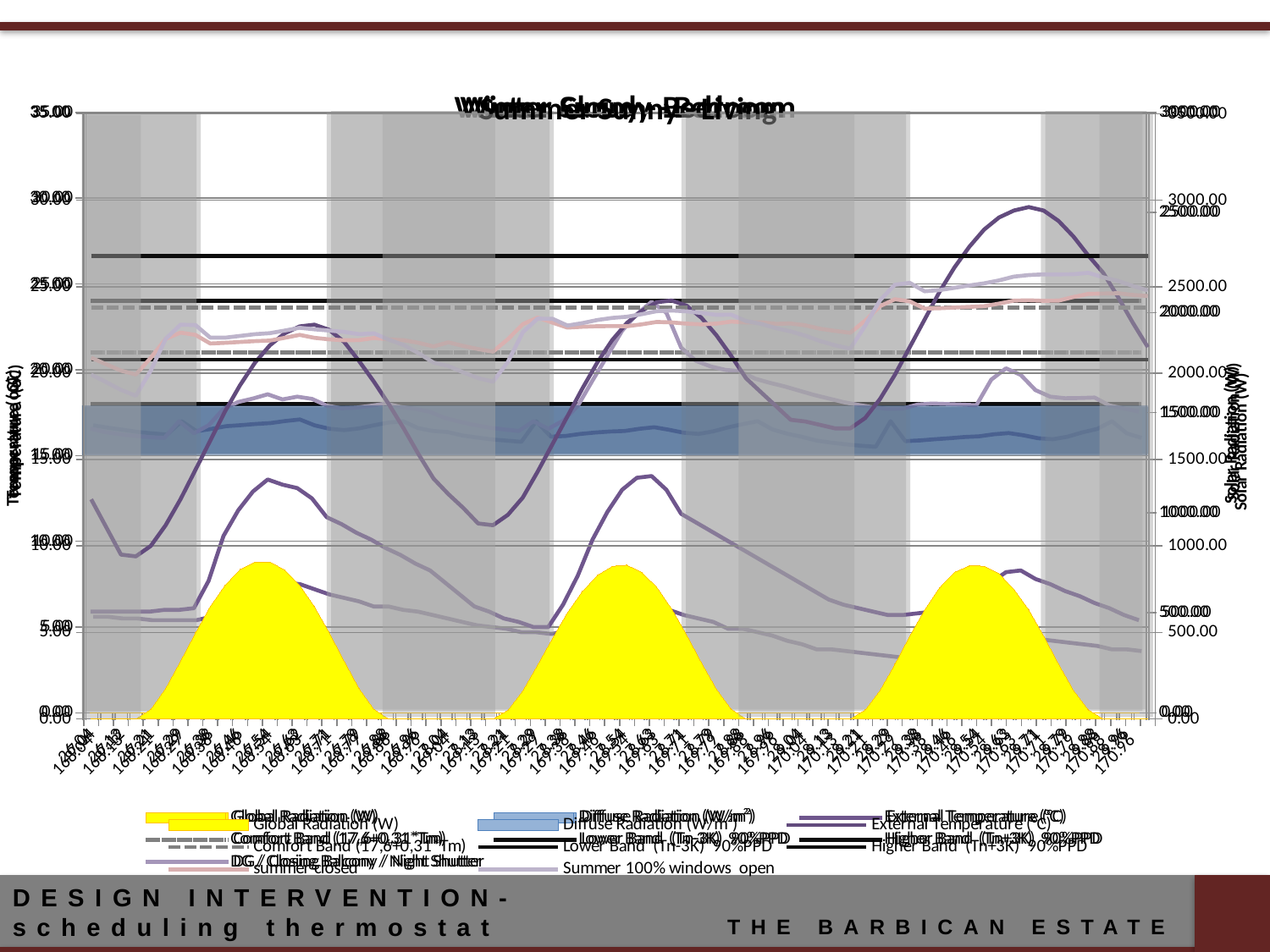
How many yellow peaks (daily cycles of the filled area) are shown across the chart? 3 What kind of chart is this (lines plotted over a filled area)? combination area and line chart Do the daily peaks of the dark purple line rise or fall from left to right across the chart? rise Which series is drawn as the yellow filled area? Global Radiation (W) What is the label of the left vertical axis? Temperature (°C) Is the highest point of the dark purple line greater or less than 25.00 on the left axis? greater